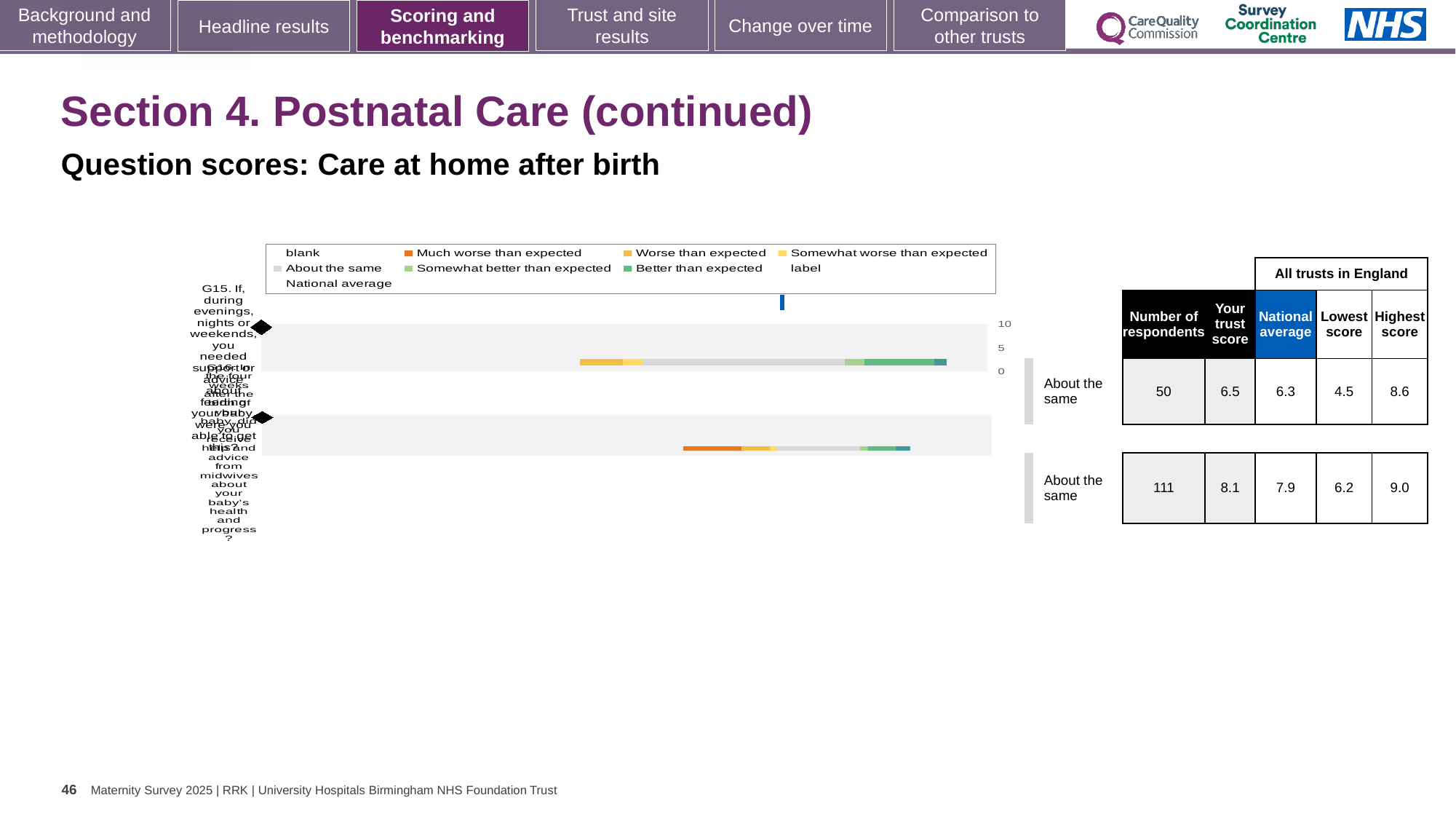
What kind of chart is shown on the slide? bar chart In the table next to the chart, what is the number of respondents for the first (top) question row? 50 What is 'Your trust score' for the second (bottom) question row? 8.1 What benchmark category is shown for both question rows? About the same For the first (top) question row, which is larger: your trust score or the national average? Your trust score How many question rows (bars) are plotted in the chart? 2 What is 'Your trust score' for the first (top) question row? 6.5 For the second (bottom) question row, what is the difference between the highest score (9.0) and the lowest score (6.2)? 2.8 What is the highest score among all trusts in England for the second (bottom) question row? 9.0 For the first (top) question row, what is the difference between the highest score (8.6) and the lowest score (4.5)? 4.1 What is the national average for the first (top) question row? 6.3 In the table next to the chart, what is the number of respondents for the second (bottom) question row? 111